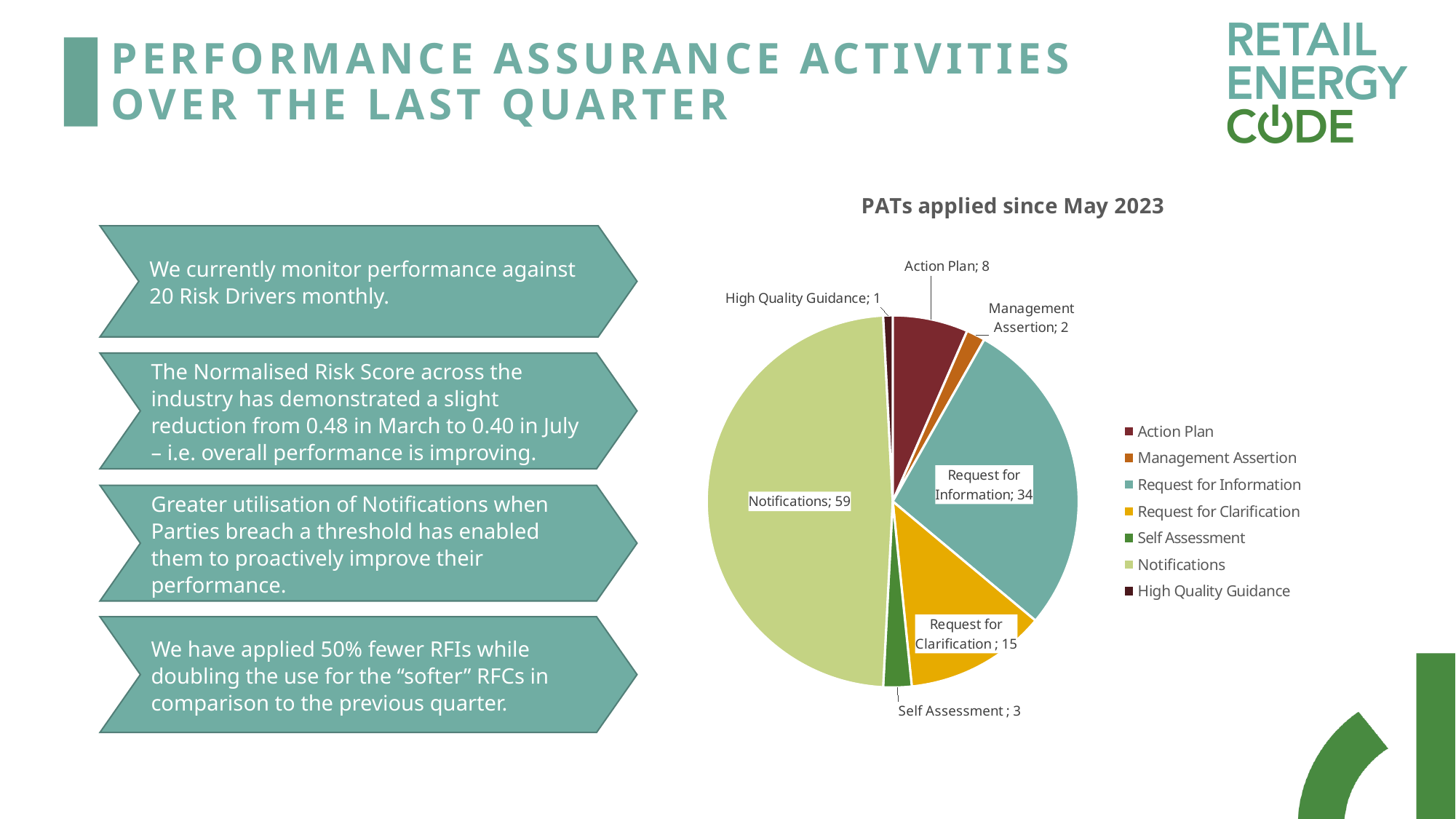
How many PATs were Notifications? 59 What is the difference between Notifications and Request for Information? 25 What is the value for Request for Clarification? 15 Which category has the largest slice of the pie? Notifications What is the value for Action Plan? 8 Which category has the smallest slice of the pie? High Quality Guidance What is the total of all the values shown in the pie chart? 122 What is the title of the chart? PATs applied since May 2023 Which is larger, Request for Clarification or Action Plan? Request for Clarification How many categories does the pie chart show? 7 What type of chart is shown on the slide? Pie chart What is the value for Request for Information? 34